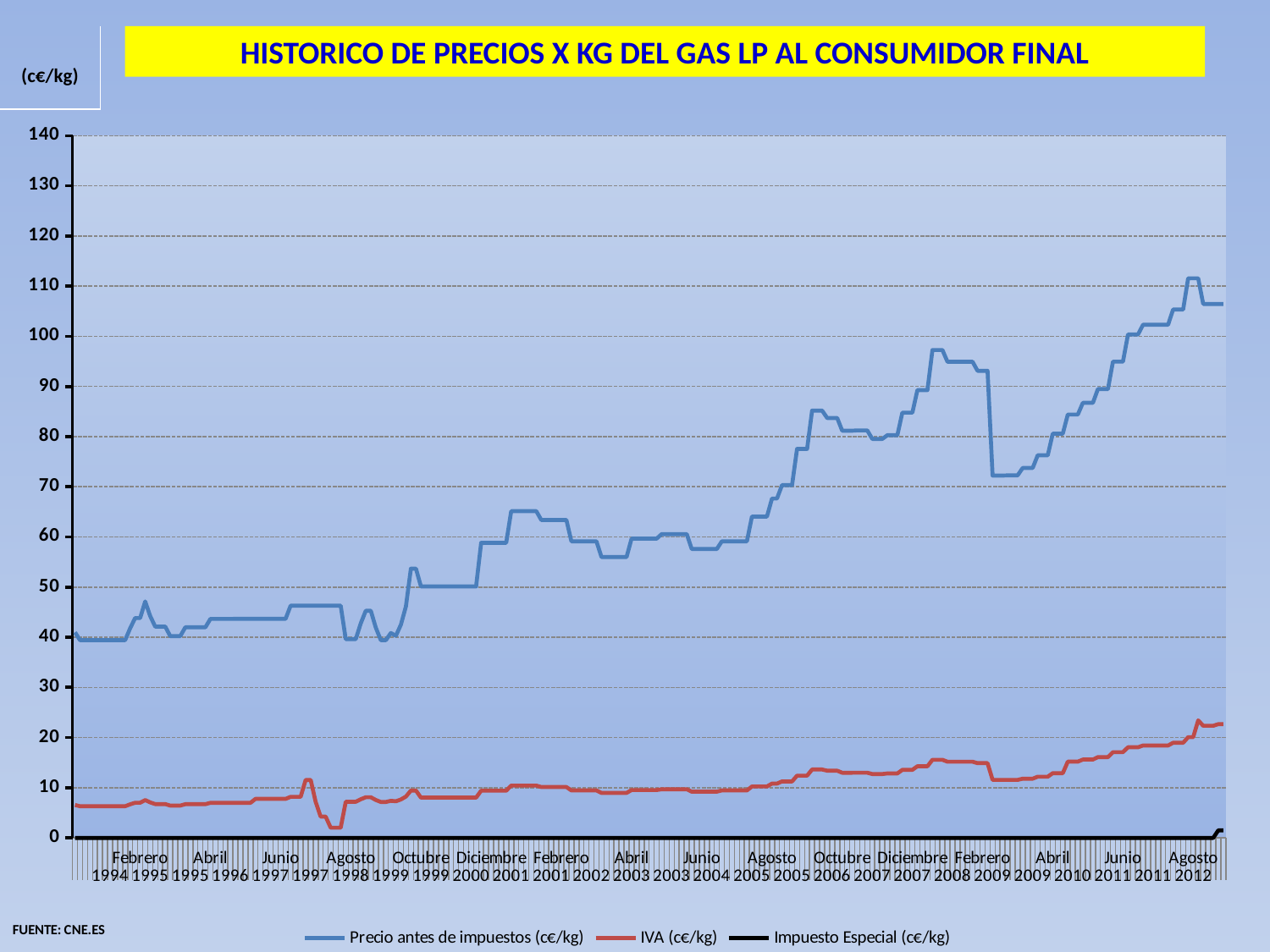
Overall, does the Precio antes de impuestos series rise or fall from left to right along the x axis? rise Which series has higher values throughout the chart, Precio antes de impuestos or IVA? Precio antes de impuestos Is the value of Precio antes de impuestos at the left end of the chart (Febrero 1994) greater or less than 50? less Which series has the lowest values on the chart? Impuesto Especial (c€/kg) What kind of chart is shown on the slide? line chart Overall, does the IVA series rise or fall from left to right along the x axis? rise Which series is plotted with the blue line? Precio antes de impuestos (c€/kg) Is the value of IVA at the left end of the chart (Febrero 1994) greater or less than 10? less Is the value of IVA at the right end of the chart (Agosto 2012) greater or less than 20? greater What is the title of the chart? HISTORICO DE PRECIOS X KG DEL GAS LP AL CONSUMIDOR FINAL How many series does the legend list? 3